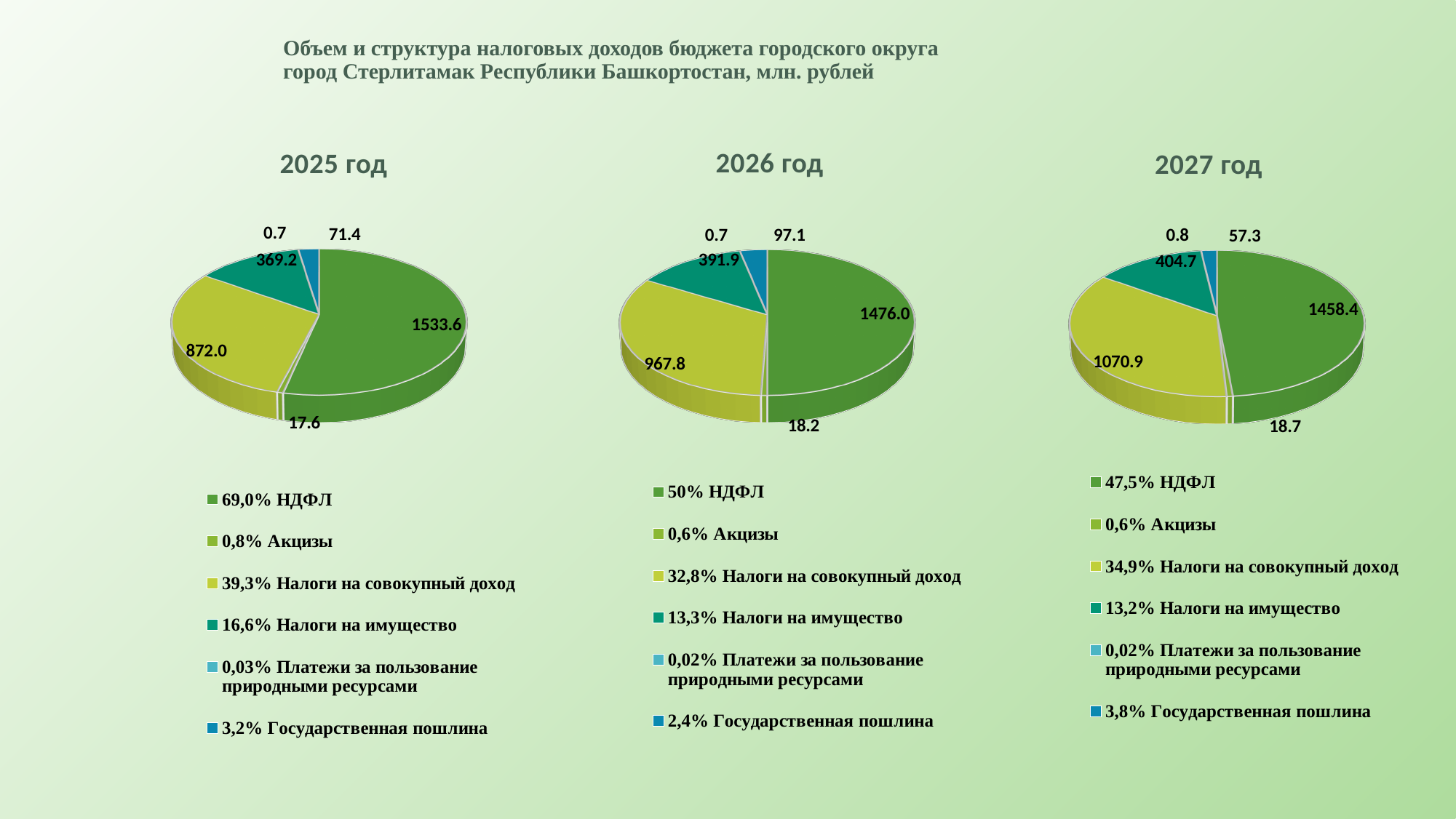
In the 2026 год chart, which category has the largest value? НДФЛ In the 2027 год chart, what is the difference between the values for НДФЛ and Налоги на совокупный доход? 387.5 What kind of chart is used for 2026 год? Pie chart According to the legend of the 2027 год chart, what share does НДФЛ have? 47,5% How many categories does the legend of the 2025 год chart list? 6 In the 2027 год chart, what is the value for Государственная пошлина? 57.3 How many pie charts are shown on the slide? 3 In the 2025 год chart, what is the value for НДФЛ? 1533.6 In the 2027 год chart, what is the value for Налоги на имущество? 404.7 In the 2026 год chart, what is the value for Налоги на совокупный доход? 967.8 In the 2025 год chart, which category has the smallest value? Платежи за пользование природными ресурсами In the 2026 год chart, which is larger: Налоги на имущество or Государственная пошлина? Налоги на имущество